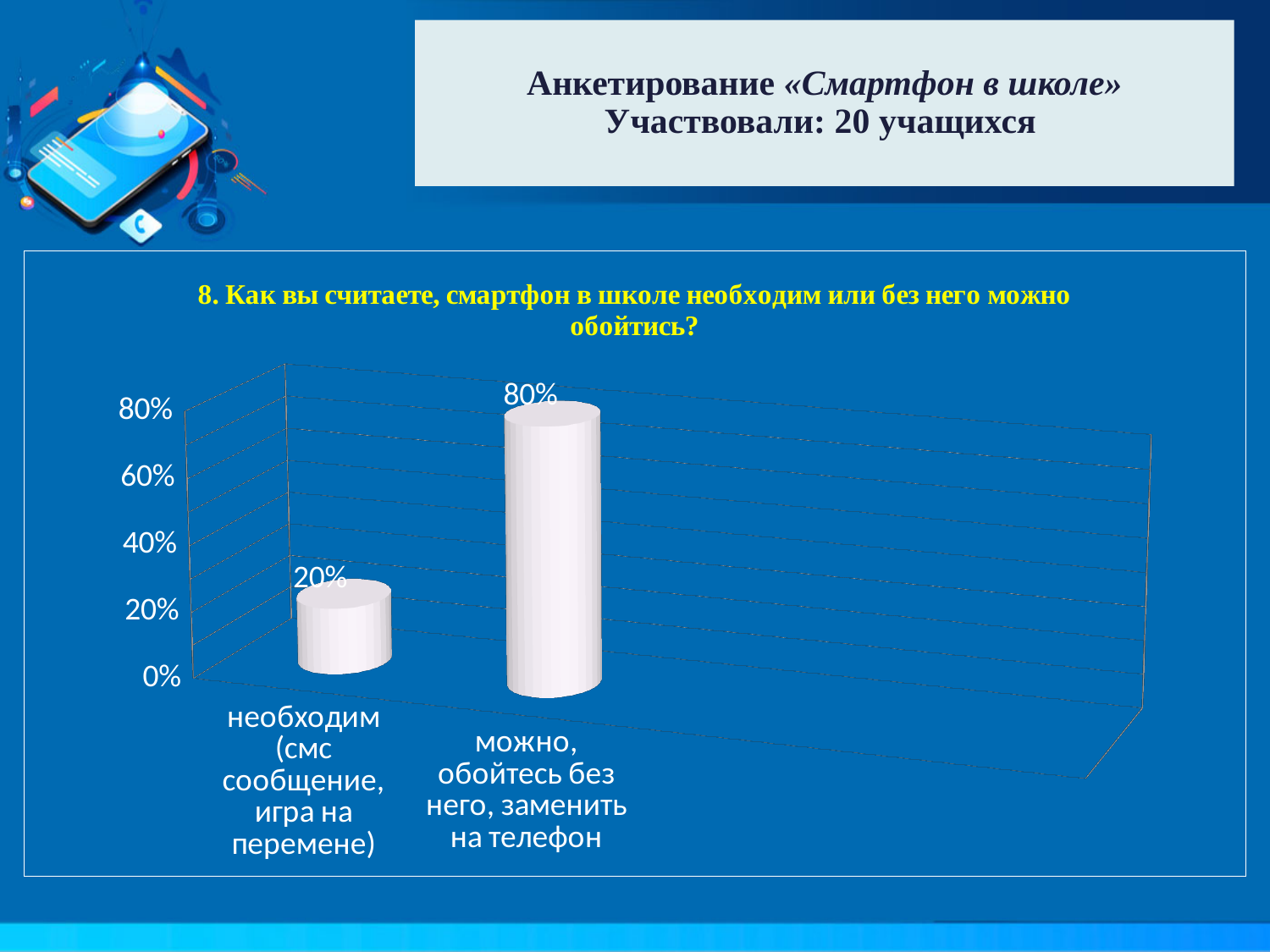
Which category has the lowest value? необходим (смс сообщение, игра на перемене) Is the value for "необходим (смс сообщение, игра на перемене)" greater or less than 40%? less Is the value for "можно, обойтесь без него, заменить на телефон" greater or less than 60%? greater How many categories are shown in the chart? 2 Which category has the highest value? можно, обойтесь без него, заменить на телефон Which is larger: the value for "необходим" or the value for "можно, обойтесь без него"? можно, обойтесь без него, заменить на телефон What kind of chart is shown on the slide? bar chart What is the value for the category "необходим (смс сообщение, игра на перемене)"? 20% What is the title of the chart? 8. Как вы считаете, смартфон в школе необходим или без него можно обойтись? What is the difference between the values for "можно, обойтесь без него, заменить на телефон" and "необходим (смс сообщение, игра на перемене)"? 60% What is the value for the category "можно, обойтесь без него, заменить на телефон"? 80% What is the highest value shown on the vertical axis of the chart? 80%